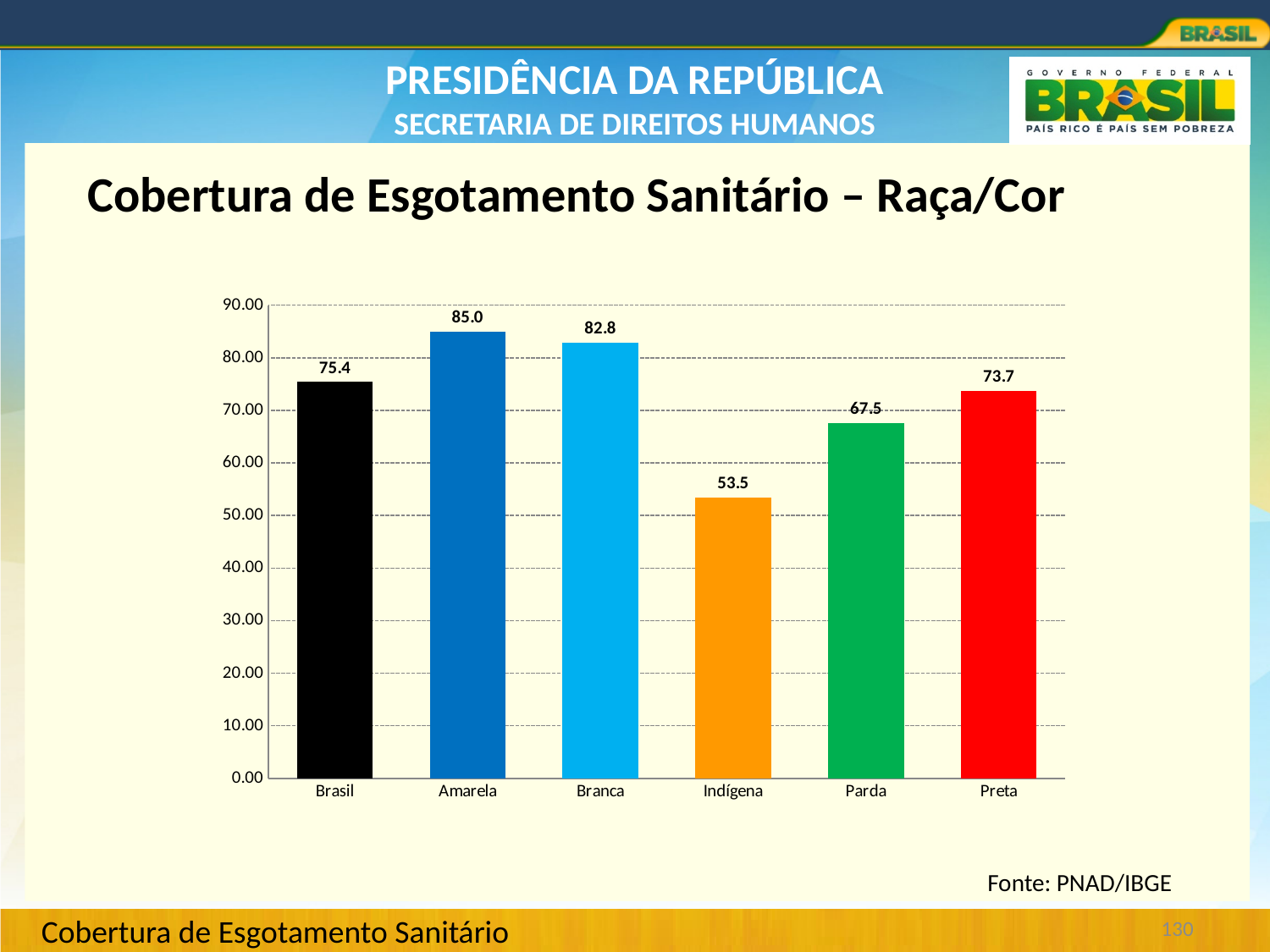
What is the value for Brasil? 75.4 Which category has the lowest value? Indígena What is the difference between the values for Amarela and Branca? 2.2 What is the value for Parda? 67.5 How many categories are shown on the x axis? 6 What is the difference between the values for Brasil and Indígena? 21.9 What kind of chart is shown on the slide? Bar chart What is the value for Preta? 73.7 What is the title of the chart? Cobertura de Esgotamento Sanitário – Raça/Cor Which is larger, the value for Parda or the value for Preta? Preta What is the value for Indígena? 53.5 Which category has the highest value? Amarela